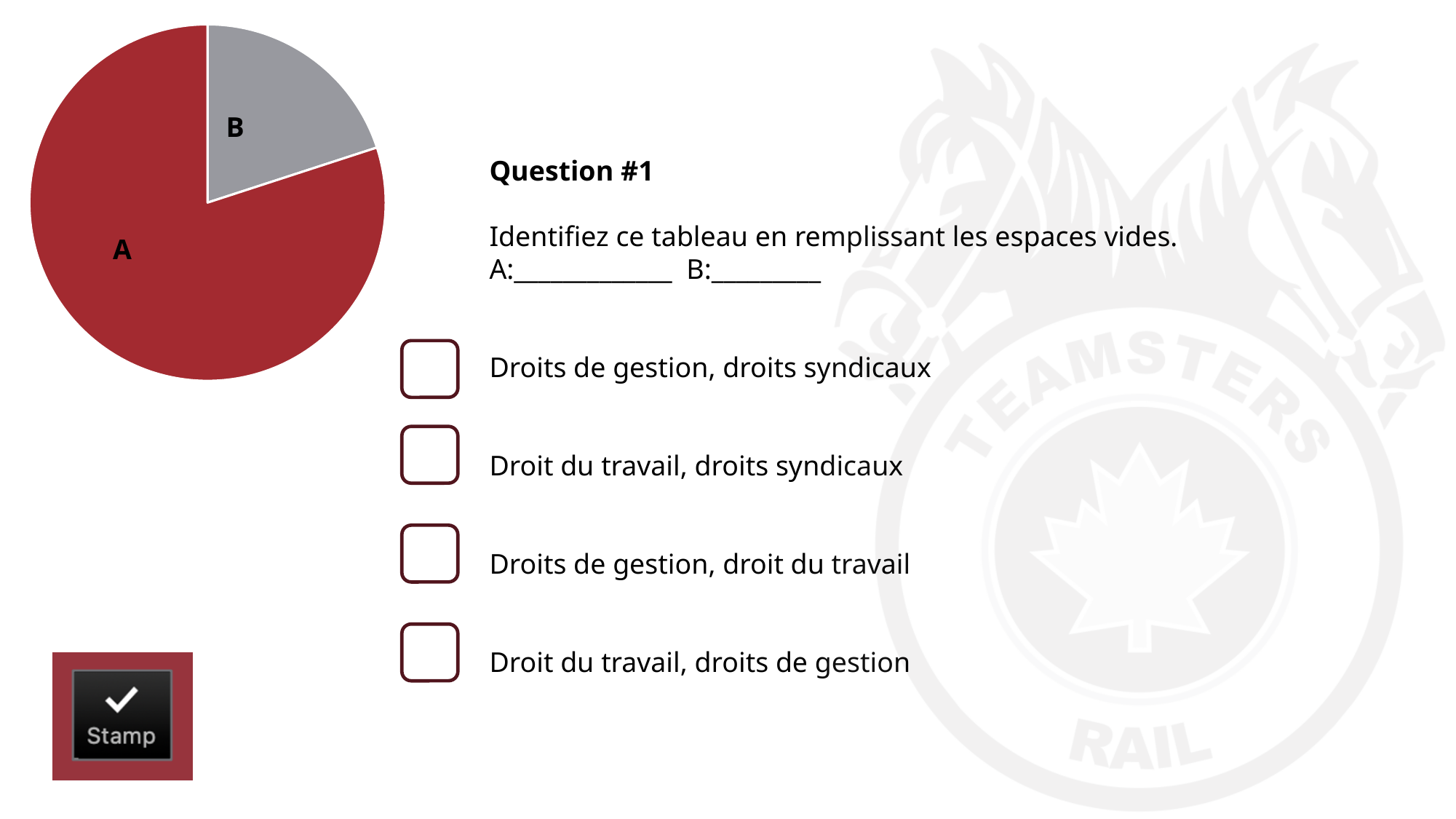
What colour is slice B in the pie chart? gray How many slices does the pie chart have? 2 What colour is slice A in the pie chart? dark red Does slice A take up more or less than half of the pie chart? more What kind of chart is shown on the slide? pie chart Which slice of the pie chart is the largest? A Which slice is larger in the pie chart, A or B? A Which slice of the pie chart is the smallest? B